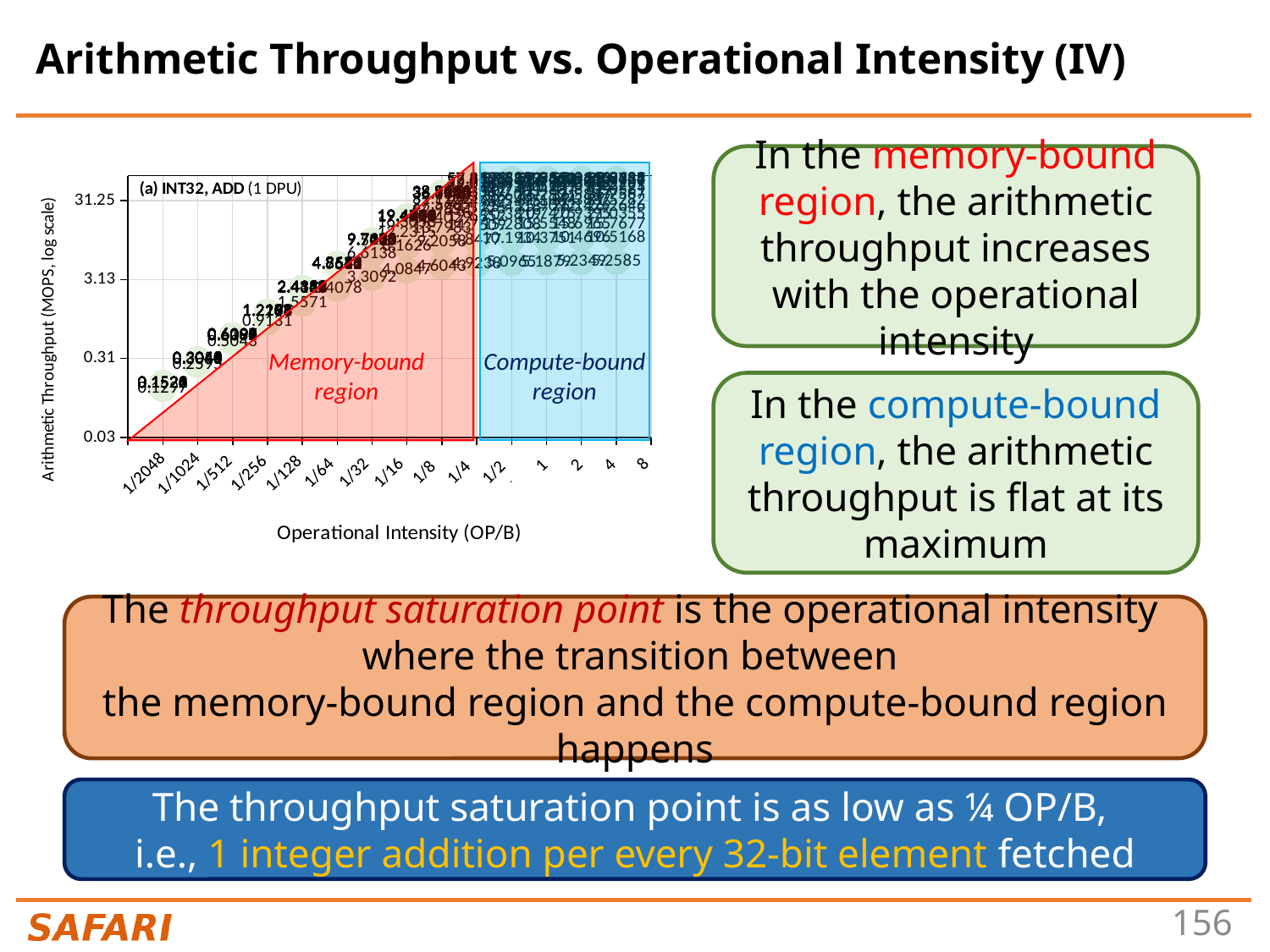
In the memory-bound region, does the arithmetic throughput rise or fall as operational intensity increases? rise Is the arithmetic throughput at operational intensity 1/2048 greater or less than 0.31? less What is the label on the x axis of the chart? Operational Intensity (OP/B) Is the arithmetic throughput at operational intensity 8 greater or less than 3.13? greater Which has the lower arithmetic throughput: operational intensity 1/512 or operational intensity 2? 1/512 What is the label on the y axis of the chart? Arithmetic Throughput (MOPS, log scale) What is the highest tick value shown on the y axis of the chart? 31.25 Which has the higher arithmetic throughput: operational intensity 1/2048 or operational intensity 1/4? 1/4 How many tick labels are shown on the x axis of the chart? 15 What is the lowest tick value shown on the y axis of the chart? 0.03 Is the arithmetic throughput at operational intensity 1/4 greater or less than 3.13? greater What kind of chart is shown on the slide? scatter chart